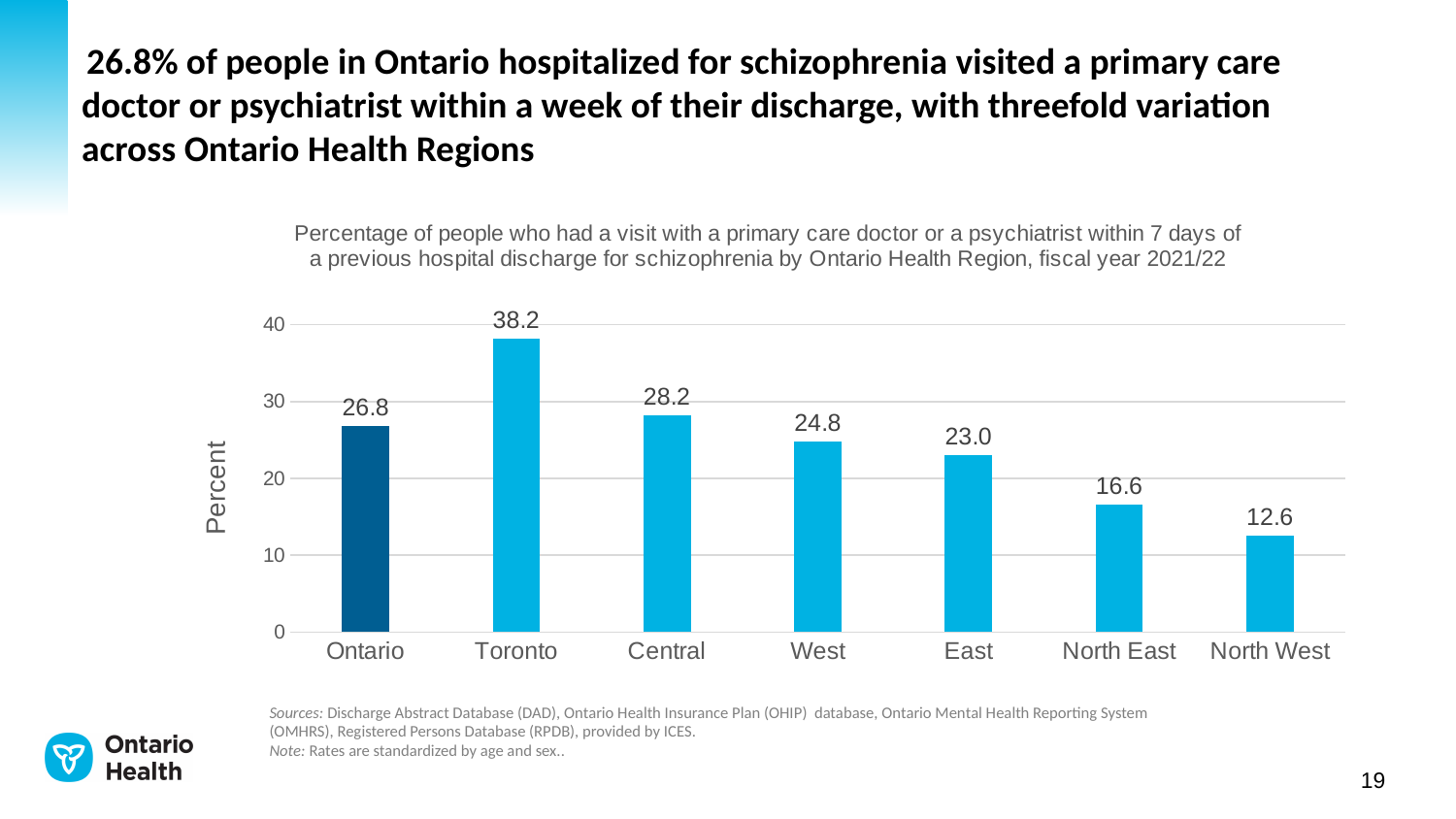
What is the label of the y axis? Percent Is the value for Central greater or less than 30? less What is the value for Toronto? 38.2 What is the value for North East? 16.6 Which is larger, the value for West or the value for East? West Which region has the highest value? Toronto What is the difference between the values for Toronto and North West? 25.6 What is the value for Ontario? 26.8 What kind of chart is shown on the slide? bar chart What is the difference between the values for Central and East? 5.2 How many categories are shown on the x axis? 7 Which region has the lowest value? North West